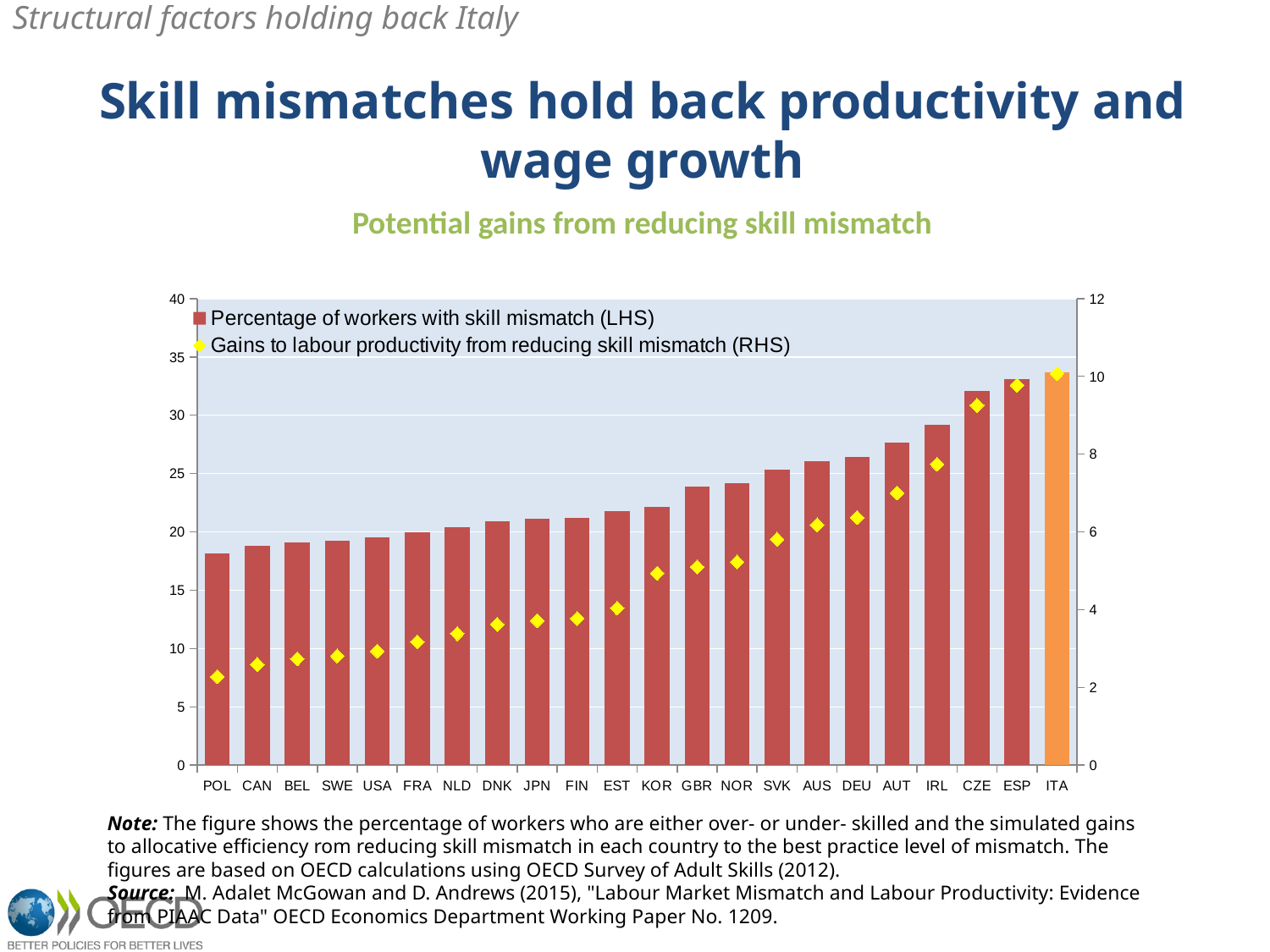
Is the percentage of workers with skill mismatch for ITA greater or less than 30? greater Is the gain to labour productivity from reducing skill mismatch for POL greater or less than 4 on the right-hand axis? less Which country has the lowest percentage of workers with skill mismatch? POL How many series does the legend list? 2 How many countries are shown on the x axis? 22 Do the bars for percentage of workers with skill mismatch rise or fall from left to right along the x axis? rise Which country has the highest percentage of workers with skill mismatch? ITA Is the percentage of workers with skill mismatch for GBR greater or less than 20? greater What kind of chart is shown on the slide? Bar chart (with diamond markers for the second series) Which has the larger percentage of workers with skill mismatch, ESP or CAN? ESP